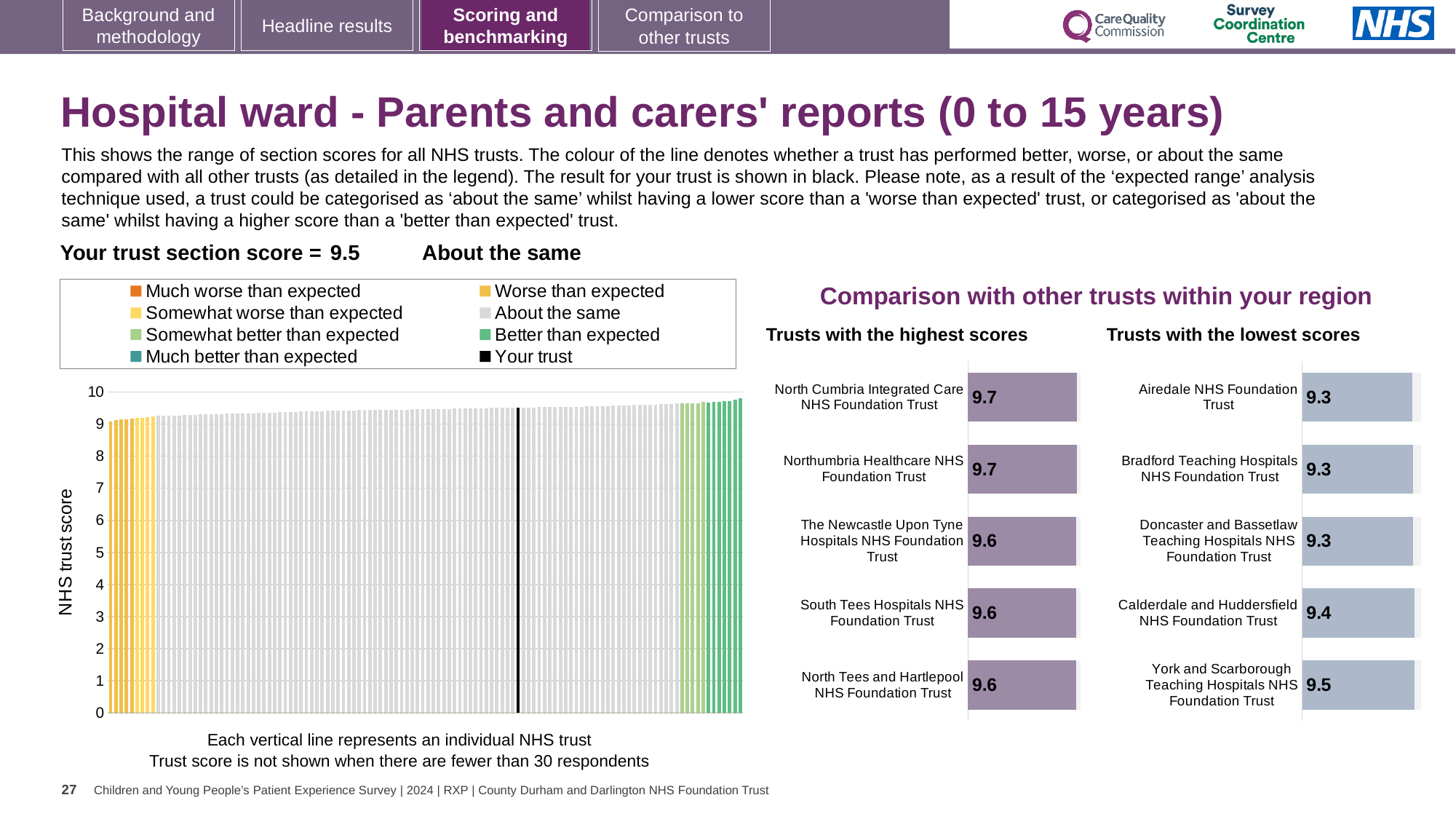
In the 'Trusts with the lowest scores' chart, what is the score for Calderdale and Huddersfield NHS Foundation Trust? 9.4 In the 'Trusts with the lowest scores' chart, which has the larger score: Calderdale and Huddersfield NHS Foundation Trust or Bradford Teaching Hospitals NHS Foundation Trust? Calderdale and Huddersfield NHS Foundation Trust In the 'Trusts with the highest scores' chart, what is the score for North Cumbria Integrated Care NHS Foundation Trust? 9.7 In the 'Trusts with the highest scores' chart, what is the score for South Tees Hospitals NHS Foundation Trust? 9.6 In the 'Trusts with the highest scores' chart, what is the difference between the scores of Northumbria Healthcare NHS Foundation Trust and North Tees and Hartlepool NHS Foundation Trust? 0.1 In the 'Trusts with the lowest scores' chart, what is the difference between the scores of York and Scarborough Teaching Hospitals NHS Foundation Trust and Airedale NHS Foundation Trust? 0.2 How many trusts are listed in the 'Trusts with the highest scores' chart? 5 In the 'NHS trust score' chart on the left, is the value for your trust greater or less than 9? greater How many trusts are listed in the 'Trusts with the lowest scores' chart? 5 What type of chart is the 'NHS trust score' chart on the left of the slide? Bar chart In the 'Trusts with the lowest scores' chart, which trust has the highest score? York and Scarborough Teaching Hospitals NHS Foundation Trust How many entries does the legend of the 'NHS trust score' chart on the left list? 8